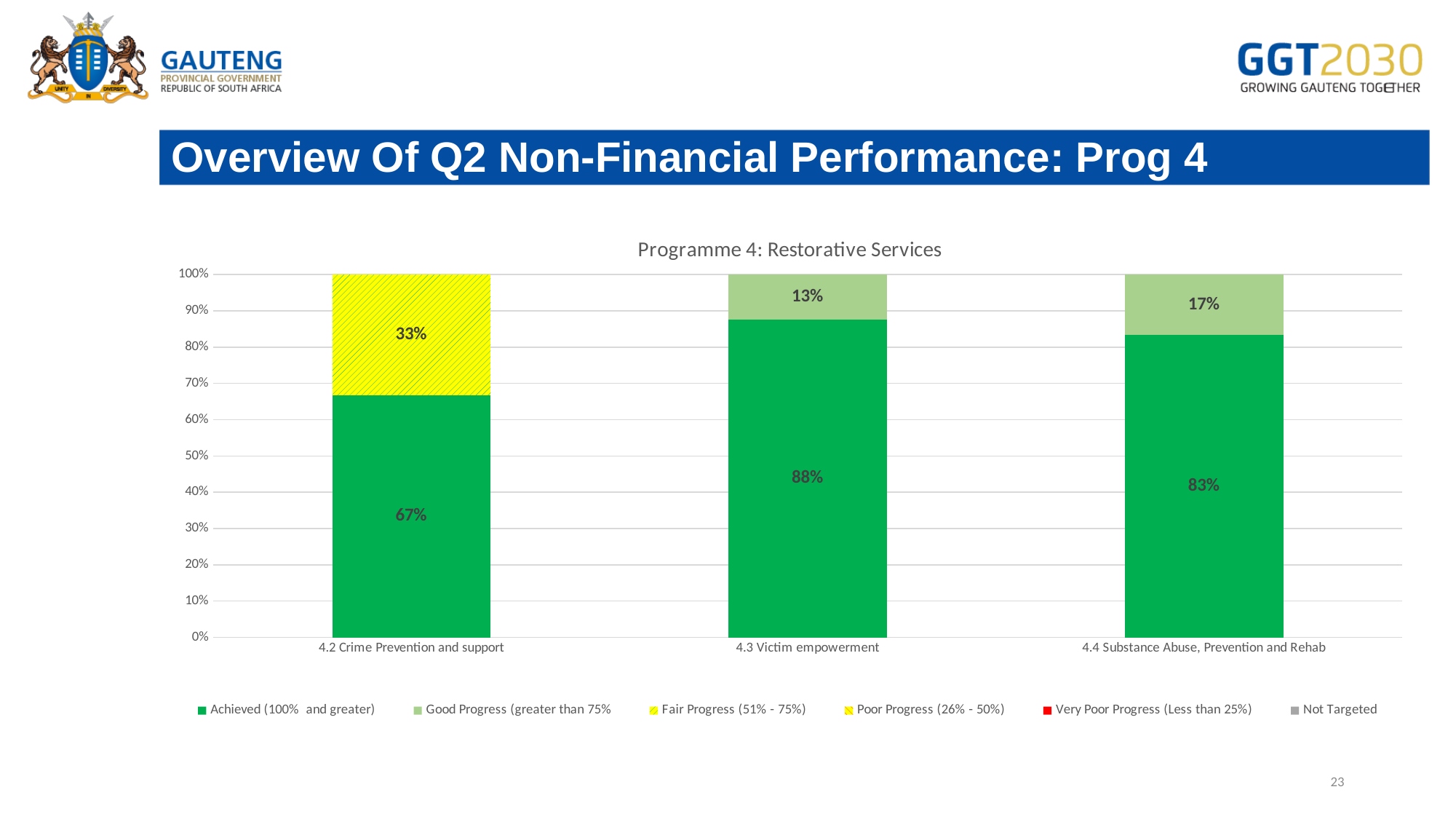
What is the Achieved (100% and greater) value for 4.2 Crime Prevention and support? 67% What is the Achieved (100% and greater) value for 4.3 Victim empowerment? 88% Is the Good Progress value for 4.3 Victim empowerment larger or smaller than the Good Progress value for 4.4 Substance Abuse, Prevention and Rehab? Smaller What is the difference between the Achieved values for 4.3 Victim empowerment and 4.4 Substance Abuse, Prevention and Rehab? 5% Which category has the highest Achieved (100% and greater) value? 4.3 Victim empowerment What is the value of the upper segment of the bar for 4.2 Crime Prevention and support? 33% How many categories are shown on the x axis of the chart? 3 What is the Good Progress (greater than 75%) value for 4.4 Substance Abuse, Prevention and Rehab? 17% How many series does the chart legend list? 6 What is the title of the chart? Programme 4: Restorative Services Which category has the lowest Achieved (100% and greater) value? 4.2 Crime Prevention and support What type of chart is shown on the slide? Stacked bar chart